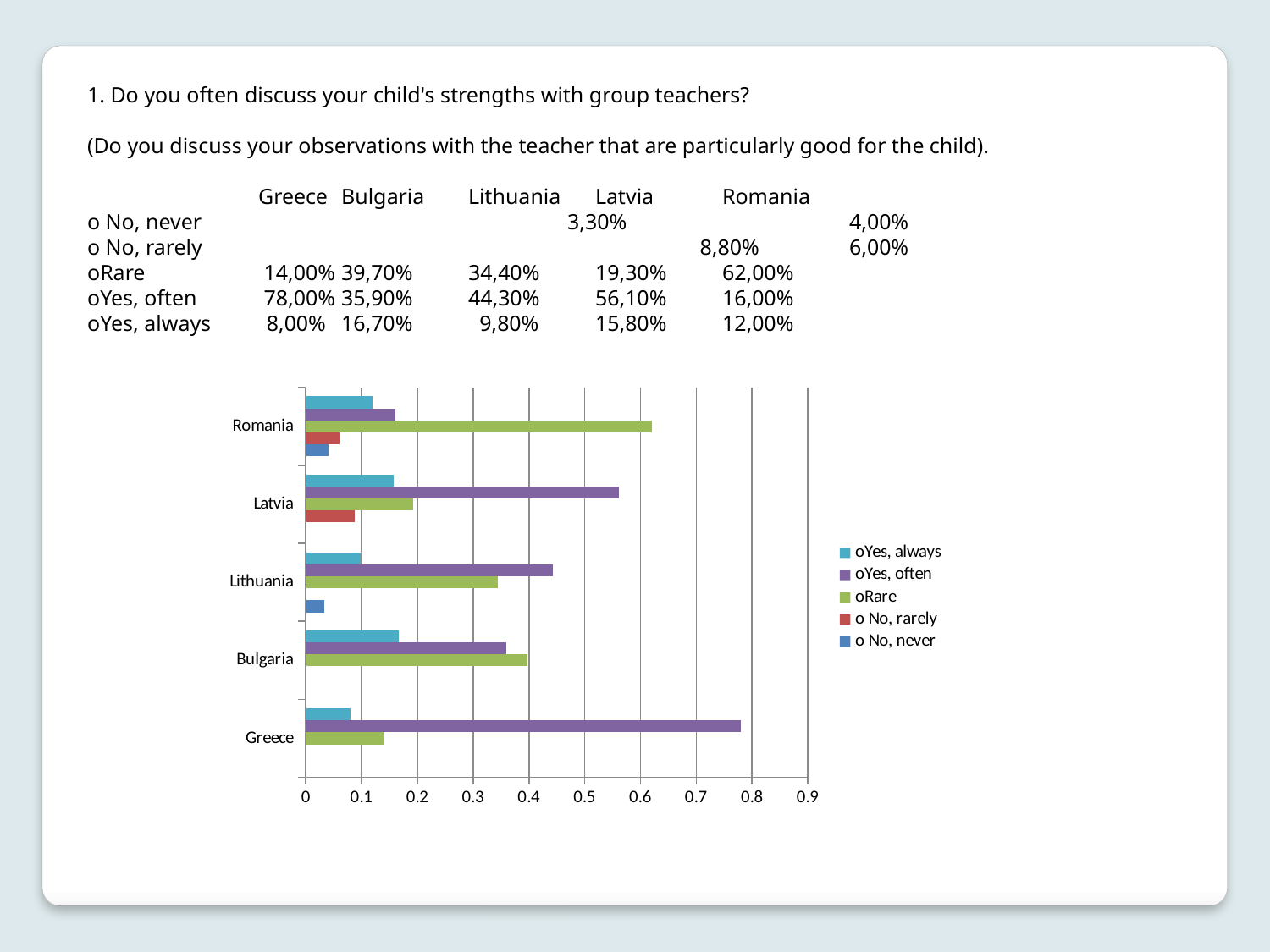
Which is larger: the 'oYes, often' value for Latvia or for Lithuania? Latvia Which country has the highest value for 'oRare'? Romania What colour represents the 'oRare' series in the chart? green How many series does the chart legend list? 5 How many countries are shown on the chart's vertical axis? 5 What kind of chart is shown on the slide? bar chart What is the value for 'oRare' for Romania? 62,00% What is the value for 'oYes, often' for Greece? 78,00% What is the difference between the 'oYes, often' and 'oYes, always' values for Greece? 70,00% Is the 'oYes, always' value for Bulgaria greater or less than 0.2? less Is the 'oRare' value for Romania greater or less than 0.5? greater Which country has the highest value for 'oYes, often'? Greece